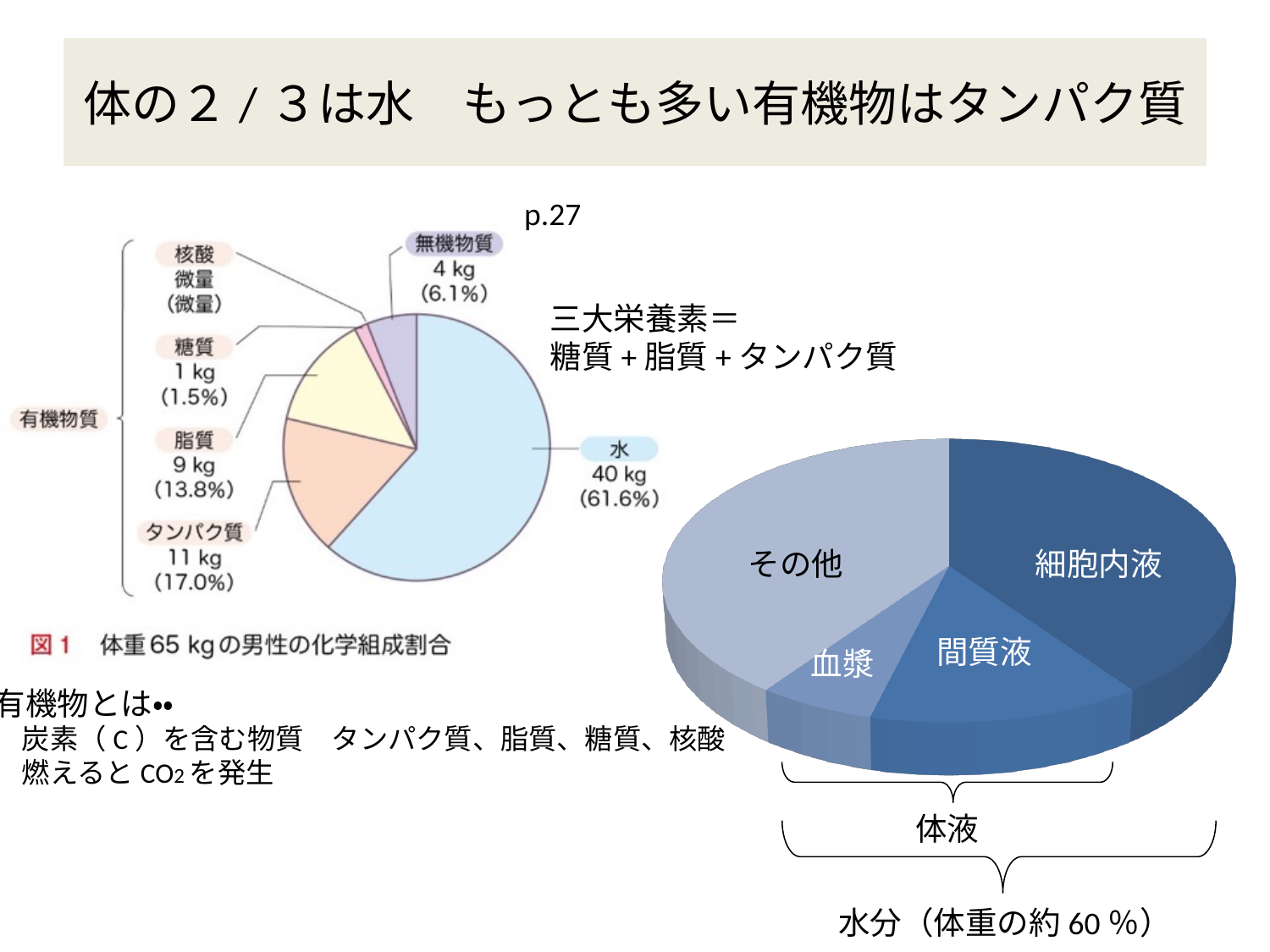
In the left pie chart (図1), which category has the largest slice? 水 In the left pie chart (図1), what is the value shown for 水? 40 kg (61.6%) In the left pie chart (図1), which category with a numeric value has the smallest slice? 糖質 In the left pie chart (図1), how many labeled categories are there? 6 In the left pie chart (図1), which is larger, 脂質 or 無機物質? 脂質 What type of chart is the chart on the right side of the slide? Pie chart In the left pie chart (図1), what is the value shown for 無機物質? 4 kg (6.1%) In the left pie chart (図1), what percentage is shown for タンパク質? 17.0% In the left pie chart (図1), how many kg of 脂質 are shown? 9 kg In the left pie chart (図1), what is the difference in kg between タンパク質 and 脂質? 2 kg In the right pie chart, how many slices are labeled? 4